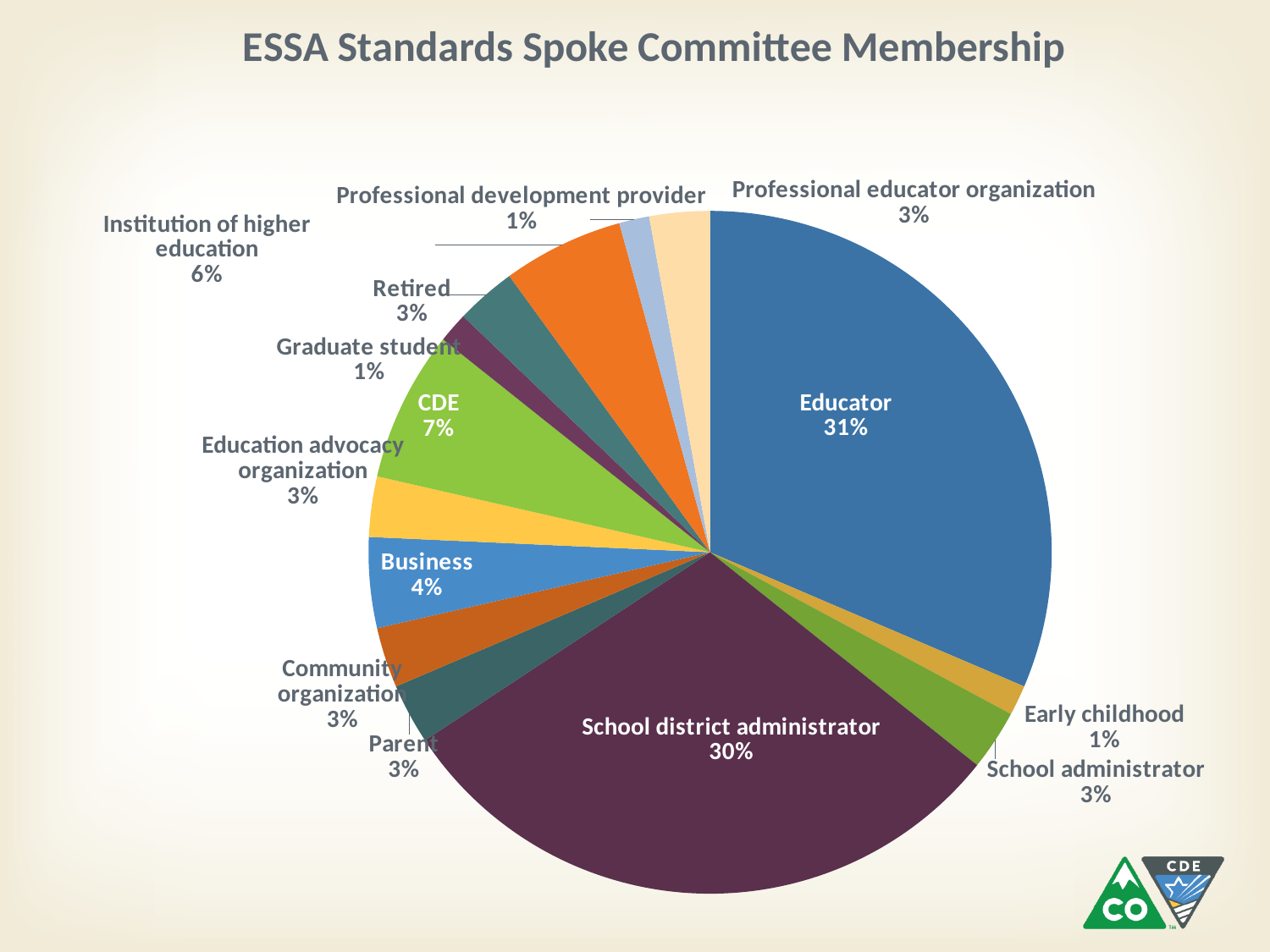
What type of chart is shown on the slide? pie chart What share of the committee membership is Educator? 31% What share of the committee membership is Professional development provider? 1% Which is larger, the share for Educator or the share for School district administrator? Educator What share of the committee membership is CDE? 7% What share of the committee membership is Institution of higher education? 6% Which category has the largest share of the committee membership? Educator How many categories are shown in the pie chart? 14 What share of the committee membership is School district administrator? 30% What share of the committee membership is Business? 4% What is the difference between the Educator share and the CDE share? 24% What is the title of the chart? ESSA Standards Spoke Committee Membership